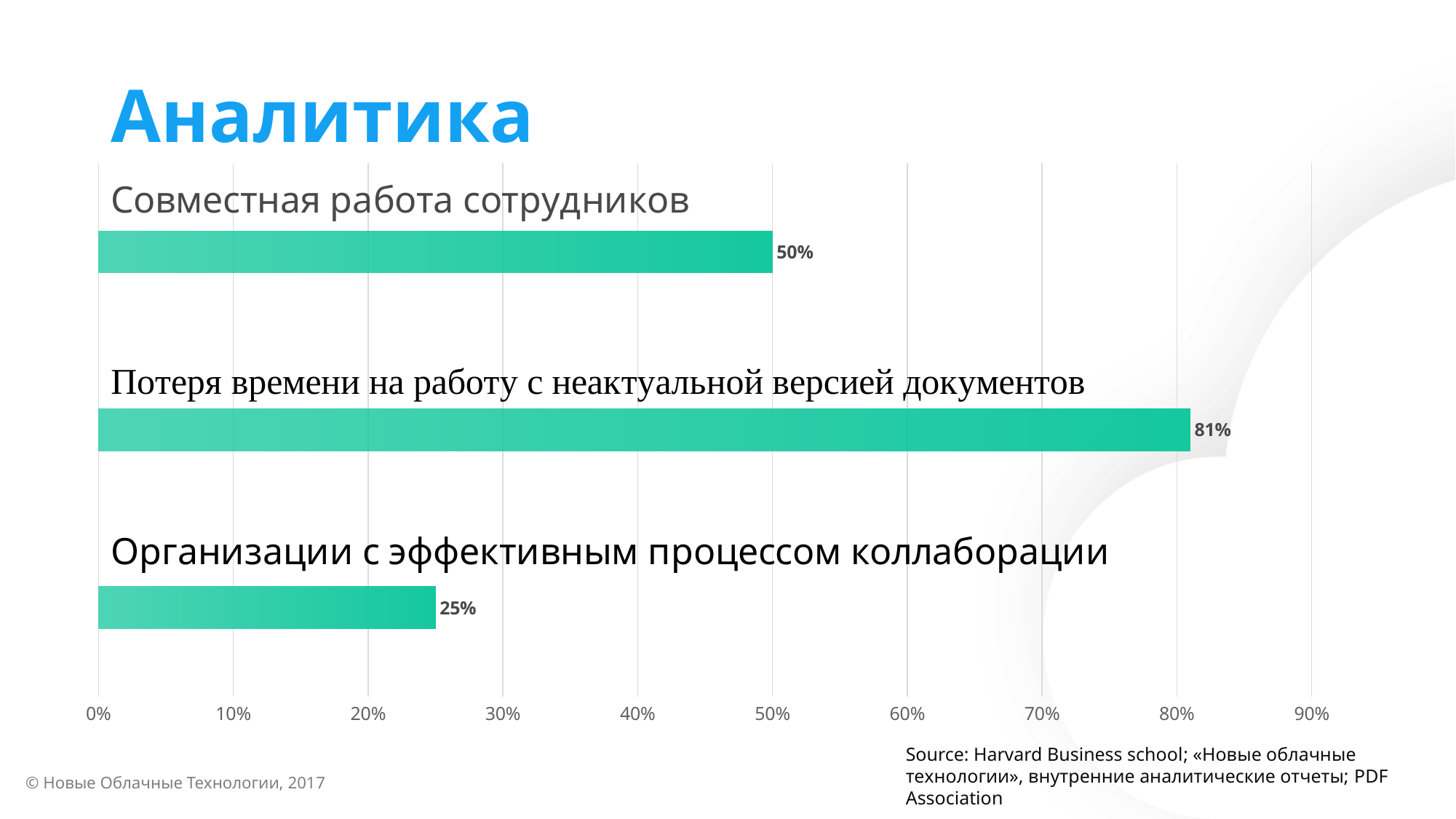
Which category has the highest value? Потеря времени на работу с неактуальной версией документов What is the value for "Потеря времени на работу с неактуальной версией документов"? 81% Is the value for "Потеря времени на работу с неактуальной версией документов" greater or less than 70%? greater What is the value for "Организации с эффективным процессом коллаборации"? 25% What kind of chart is shown on the slide? Bar chart Which is larger: the value for "Совместная работа сотрудников" or for "Организации с эффективным процессом коллаборации"? Совместная работа сотрудников What is the difference between the values for "Потеря времени на работу с неактуальной версией документов" and "Совместная работа сотрудников"? 31% What is the value for "Совместная работа сотрудников"? 50% What is the difference between the values for "Совместная работа сотрудников" and "Организации с эффективным процессом коллаборации"? 25% What is the title of the slide? Аналитика Which category has the lowest value? Организации с эффективным процессом коллаборации How many categories are shown in the chart? 3